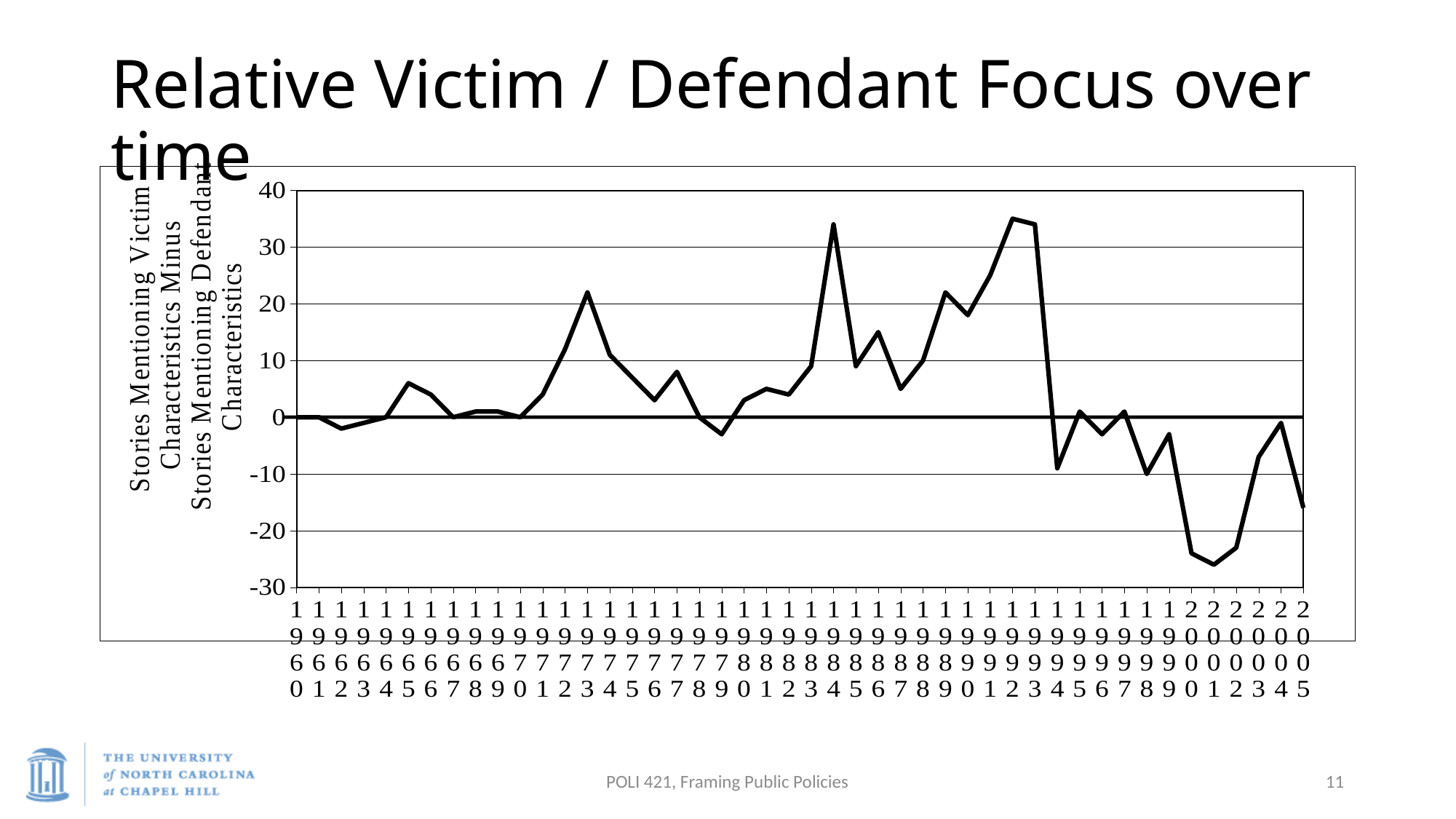
Is the value for 2005 greater or less than -10? less Is the value for 1989 greater or less than 10? greater Which year has the larger value, 1984 or 1973? 1984 Is the value for 1984 greater or less than 30? greater Which year has the lowest value on the chart? 2001 What is the first year shown on the x axis? 1960 What kind of chart is shown on the slide? line chart Do the values rise or fall between 1992 and 1994? fall What is the last year shown on the x axis? 2005 How many years (data points) are plotted along the x axis? 46